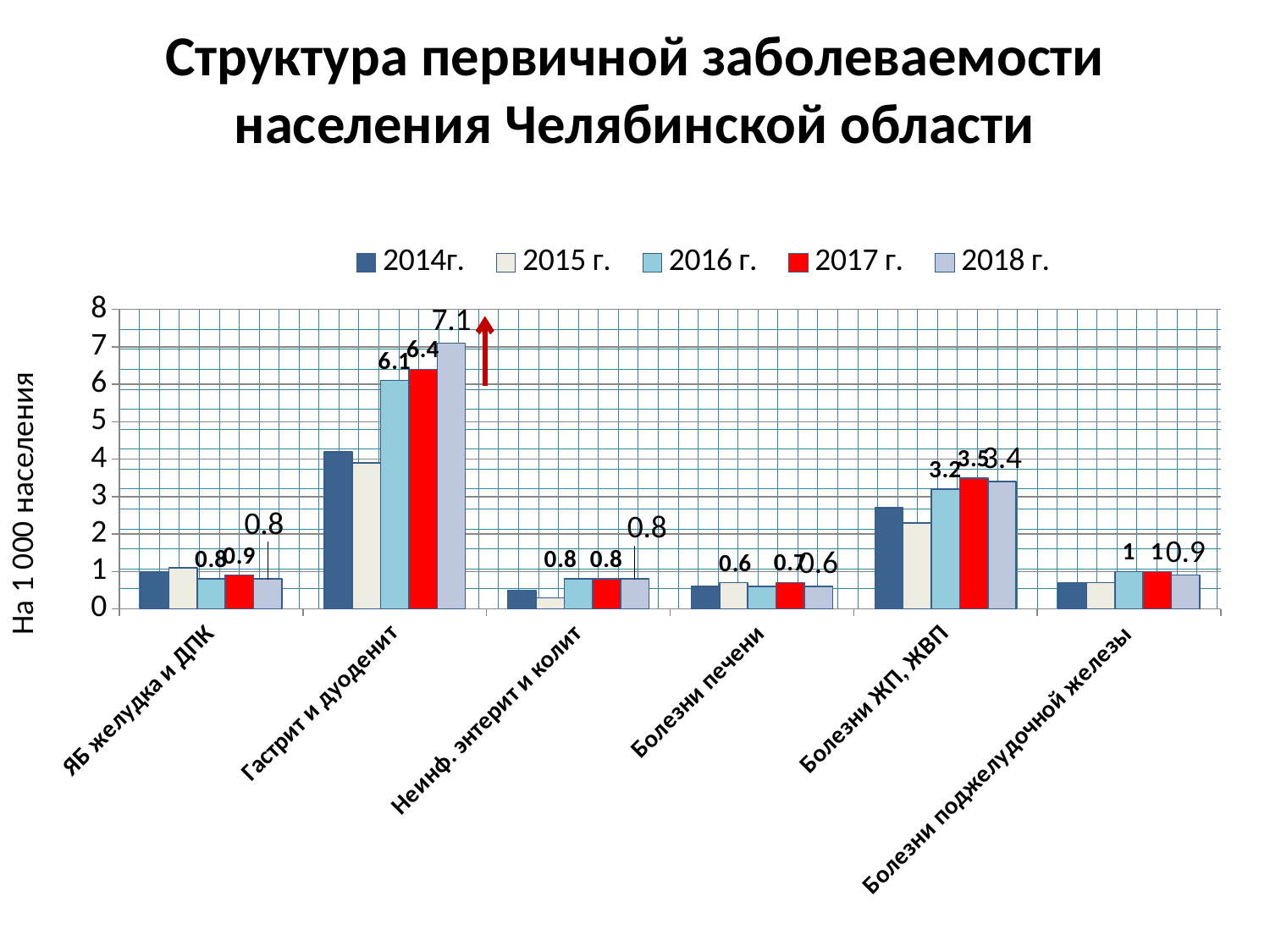
How many disease categories are shown on the x axis? 6 What is the label of the vertical axis? На 1 000 населения Do the values for Гастрит и дуоденит rise or fall from 2016 г. to 2018 г.? rise Is the value for Гастрит и дуоденит in 2014г. greater or less than 5? less Which is larger for 2017 г.: Гастрит и дуоденит or Болезни ЖП, ЖВП? Гастрит и дуоденит How many series does the legend list? 5 What is the value for Болезни ЖП, ЖВП in 2016 г.? 3.2 What is the difference between the 2018 г. and 2016 г. values for Гастрит и дуоденит? 1 Which category has the highest value for 2018 г.? Гастрит и дуоденит What kind of chart is shown on the slide? bar chart What is the value for Болезни ЖП, ЖВП in 2017 г.? 3.5 What is the value for Гастрит и дуоденит in 2018 г.? 7.1